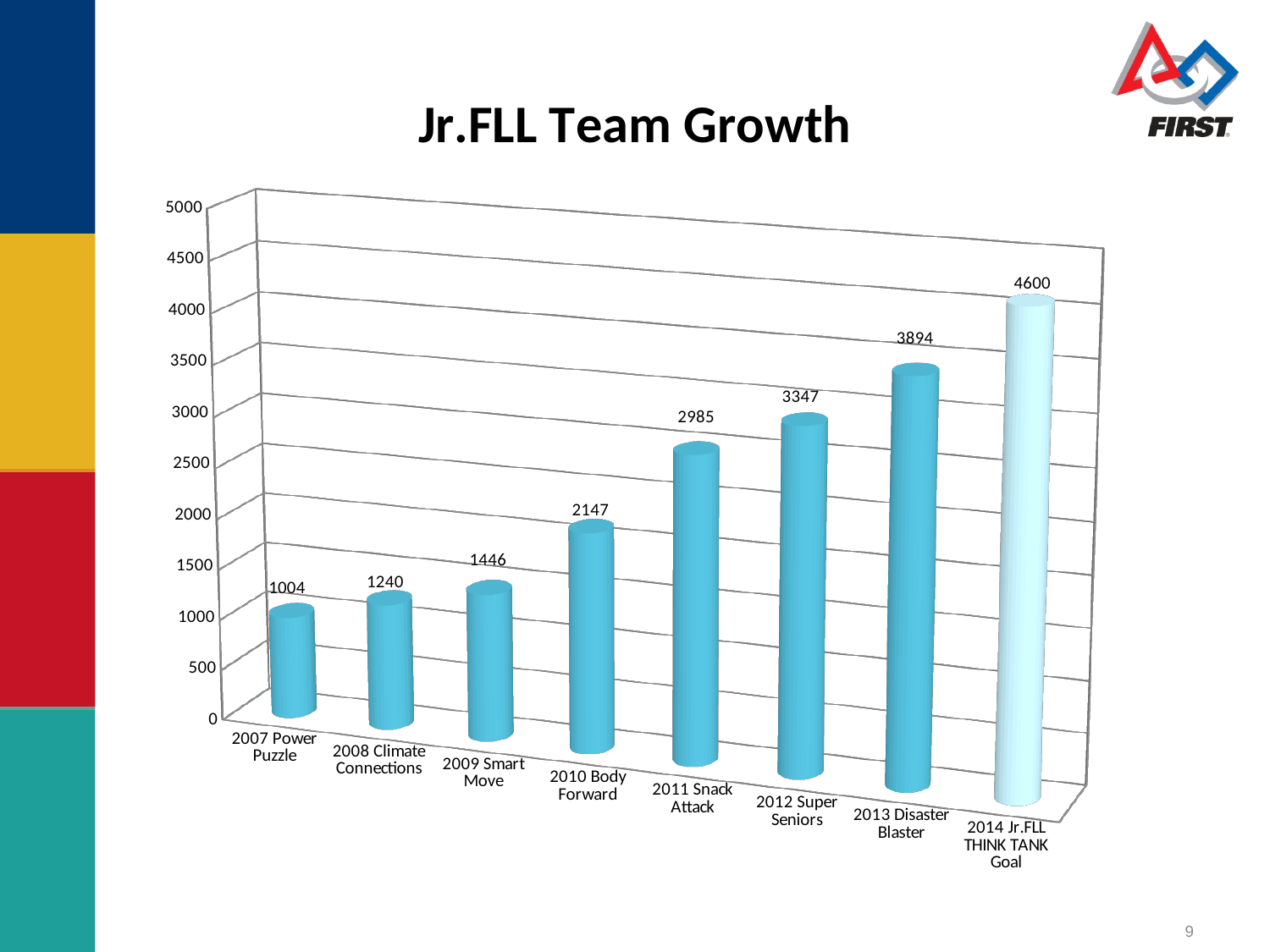
What is the value for 2011 Snack Attack? 2985 What is the difference between the values for 2013 Disaster Blaster and 2012 Super Seniors? 547 Which category has the lowest value? 2007 Power Puzzle What is the title of the chart? Jr.FLL Team Growth What kind of chart is this? bar chart How many categories are shown on the chart? 8 Which category has the highest value? 2014 Jr.FLL THINK TANK Goal What is the value for 2007 Power Puzzle? 1004 Do the values rise or fall from left to right along the x axis? rise Which is larger, the value for 2008 Climate Connections or the value for 2009 Smart Move? 2009 Smart Move What is the value for 2013 Disaster Blaster? 3894 What is the difference between the values for 2010 Body Forward and 2009 Smart Move? 701